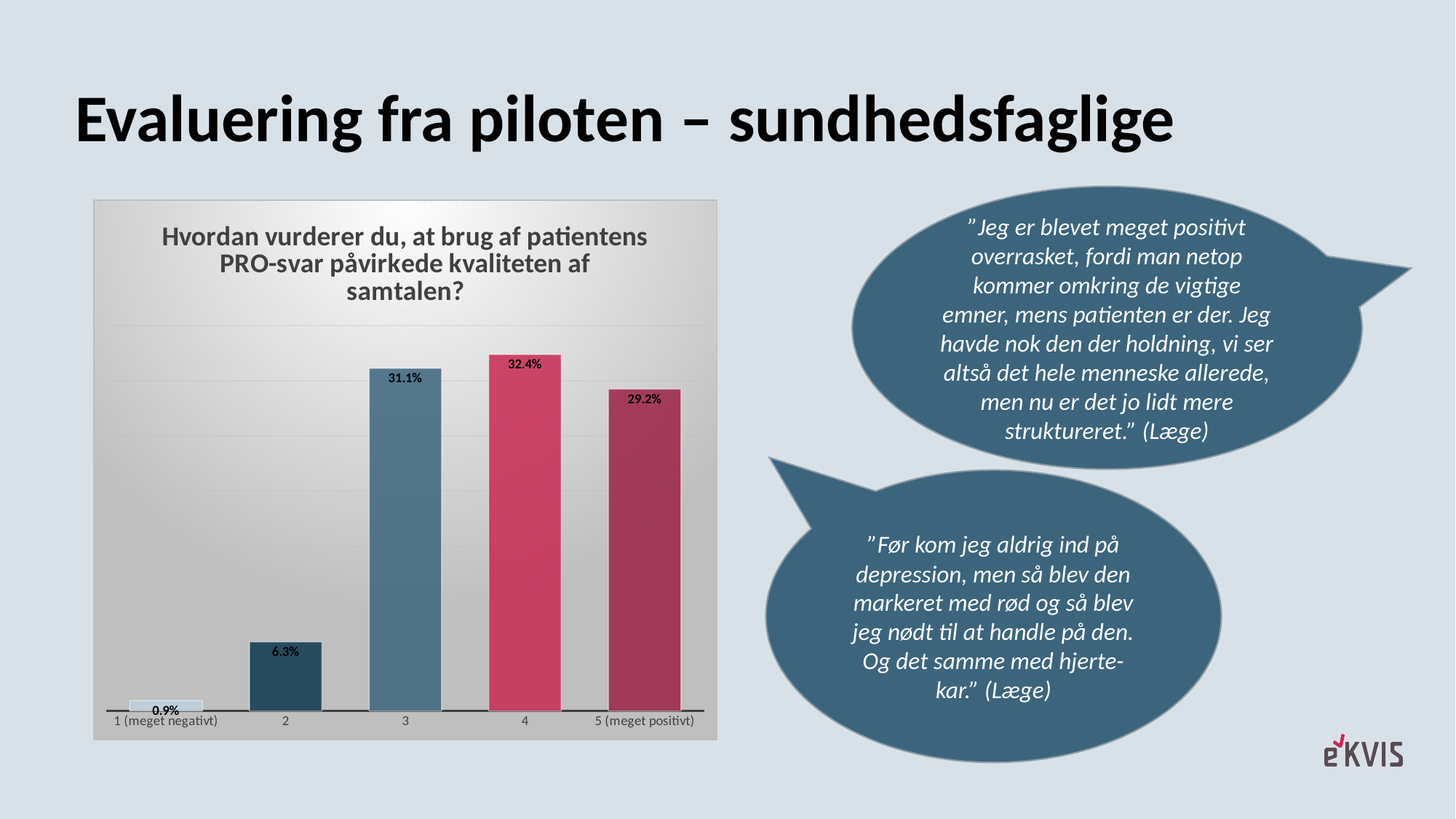
What is the difference between the values for rating 2 and rating 1 (meget negativt)? 5.4% What percentage is shown for rating 3? 31.1% What is the difference between the values for rating 4 and rating 3? 1.3% What is the title of the chart? Hvordan vurderer du, at brug af patientens PRO-svar påvirkede kvaliteten af samtalen? How many rating categories are shown on the x axis? 5 What is the value for "5 (meget positivt)"? 29.2% Which is larger, the value for rating 3 or the value for rating 5 (meget positivt)? 3 What percentage of respondents chose rating 4? 32.4% Which rating category has the highest value? 4 Which rating category has the lowest value? 1 (meget negativt) What type of chart is shown on the slide? Bar chart What is the value shown for the category "1 (meget negativt)"? 0.9%